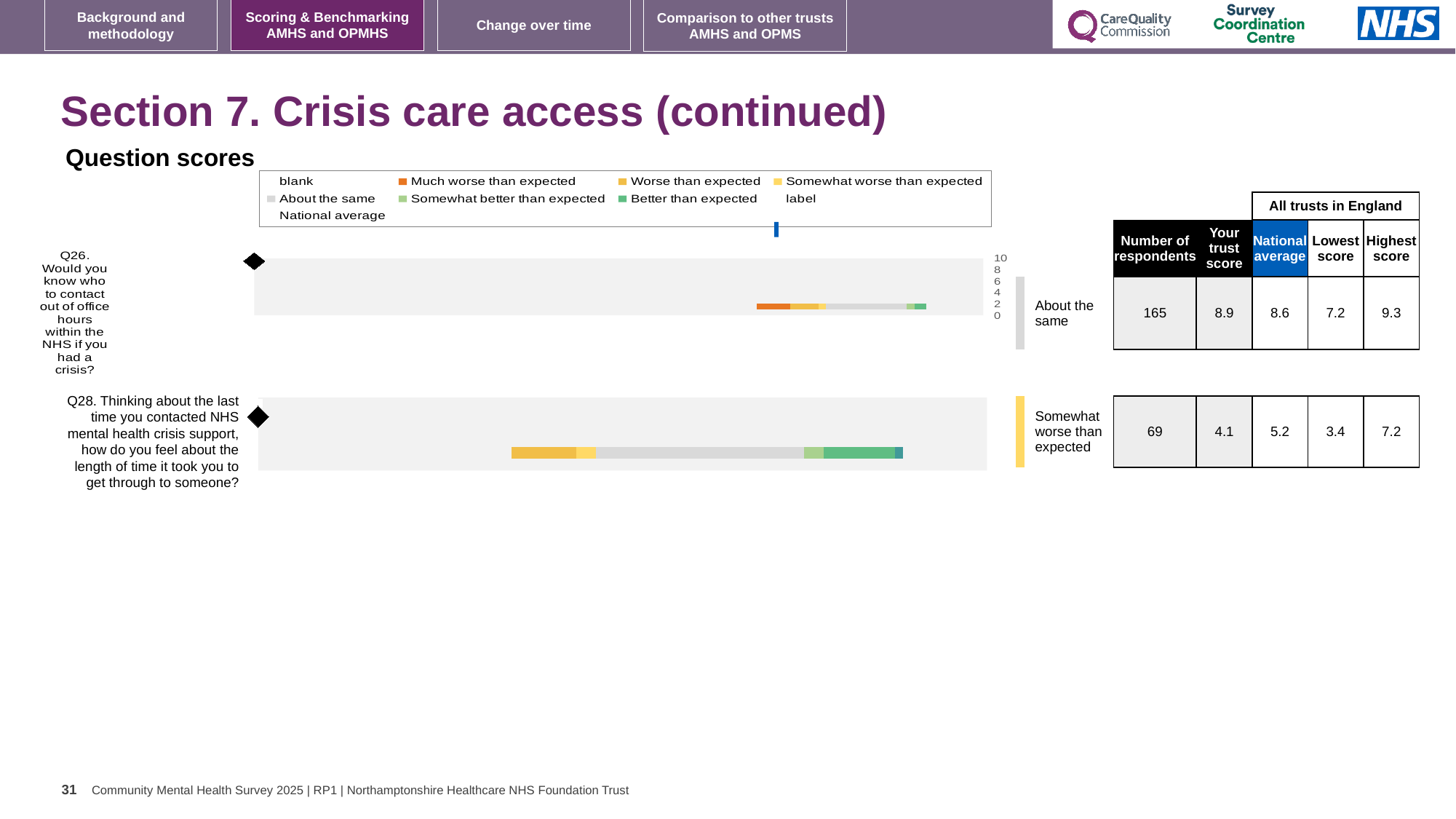
Which benchmark category is shown for Q26 in the Question scores chart? About the same How many questions (categories) are plotted in the Question scores chart? 2 How many entries does the legend of the Question scores chart list? 9 What is the national average for Q26? 8.6 What is the difference between the trust score and the national average for Q26? 0.3 What is the trust score for Q28? 4.1 What is the highest score among all trusts in England for Q28? 7.2 Which question has the higher trust score, Q26 or Q28? Q26 Is the trust score for Q28 higher or lower than the national average for Q28? lower What is the number of respondents for Q26? 165 Which benchmark category is shown for Q28 in the Question scores chart? Somewhat worse than expected What kind of chart is shown under 'Question scores'? bar chart